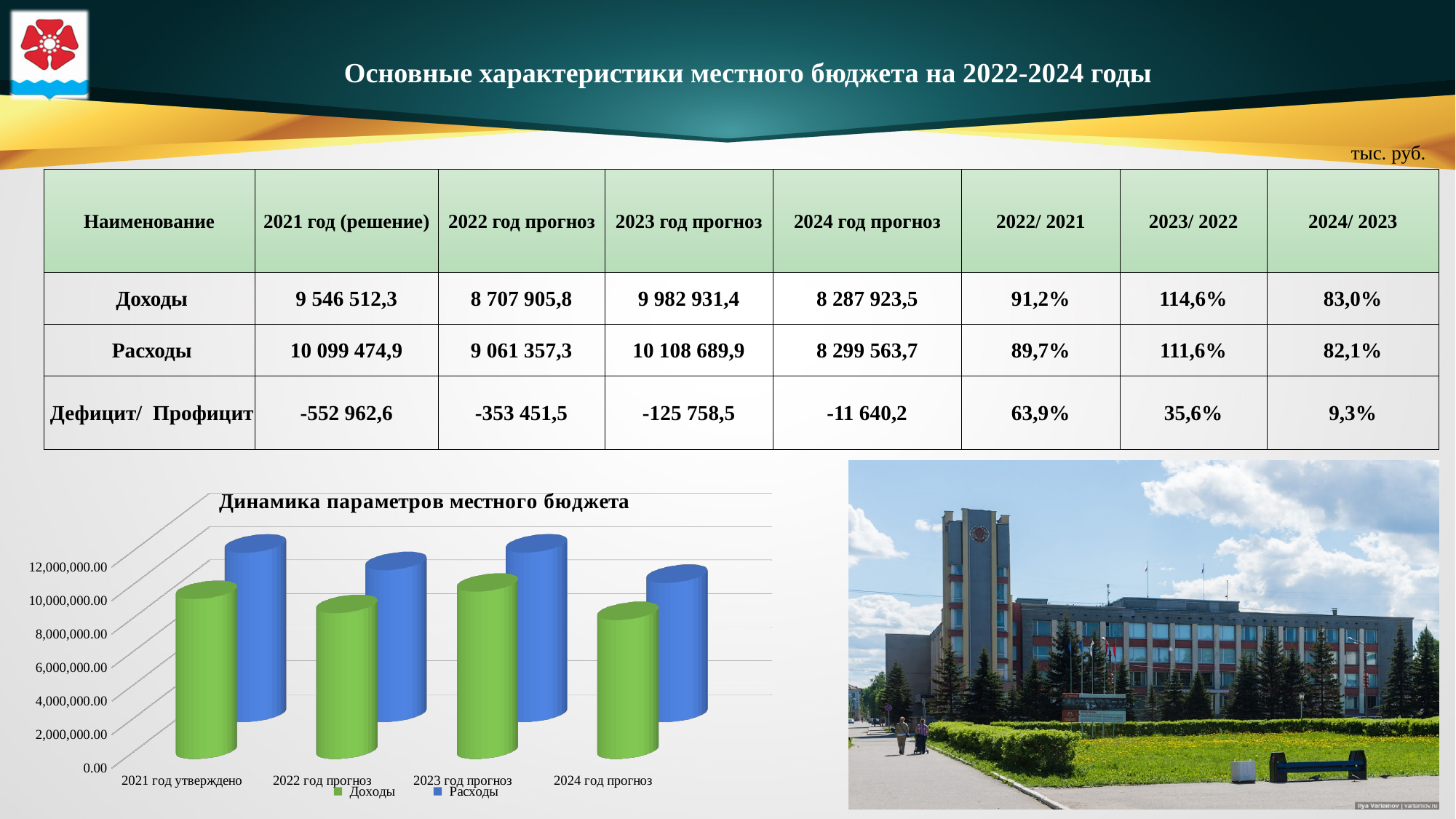
How many series does the chart legend list? 2 What is the title of the chart on the slide? Динамика параметров местного бюджета In the chart, which is larger for 2024 год прогноз: Доходы or Расходы? Расходы In the chart, is the value of Расходы for 2023 год прогноз greater or less than 6,000,000.00? greater In the chart, is the value of Доходы for 2024 год прогноз greater or less than 10,000,000.00? less In the chart, which is larger for 2021 год утверждено: Доходы or Расходы? Расходы In the chart, is the value of Доходы for 2021 год утверждено greater or less than 8,000,000.00? greater What kind of chart is shown on the slide? bar chart How many year categories are shown on the x axis of the chart? 4 In the chart, which year has the lowest value for Доходы? 2024 год прогноз Which series is shown in blue in the chart? Расходы